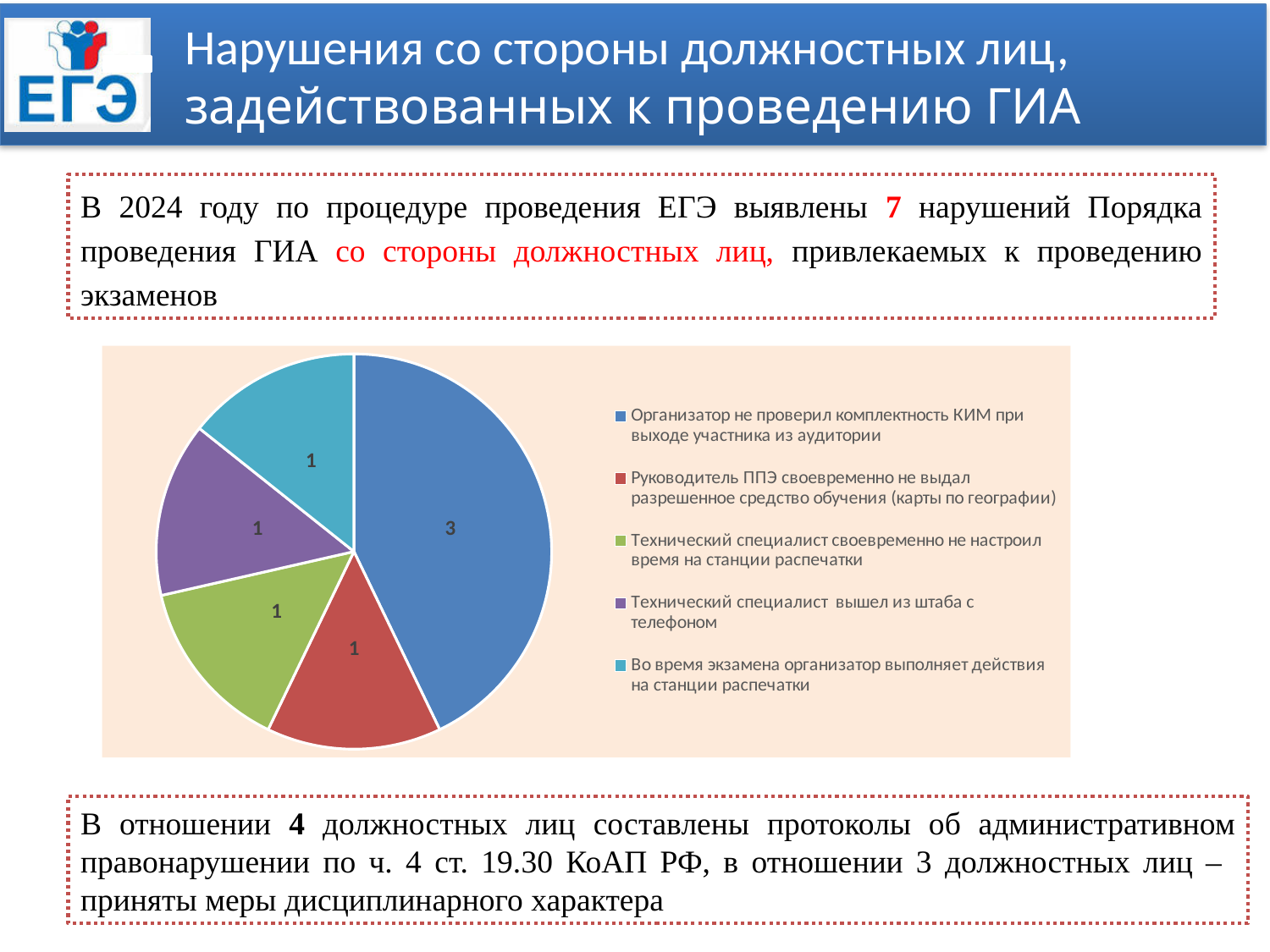
How many entries does the legend of the pie chart list? 5 How many slices does the pie chart have? 5 What colour is the slice for "Технический специалист вышел из штаба с телефоном"? purple What kind of chart is shown on the slide? pie chart Which is larger: the slice for "Организатор не проверил комплектность КИМ при выходе участника из аудитории" or the slice for "Технический специалист своевременно не настроил время на станции распечатки"? Организатор не проверил комплектность КИМ при выходе участника из аудитории What is the value of the slice for "Технический специалист вышел из штаба с телефоном"? 1 What share of the pie does the slice for "Организатор не проверил комплектность КИМ при выходе участника из аудитории" represent? 3 out of 7 What is the value of the slice for "Руководитель ППЭ своевременно не выдал разрешенное средство обучения (карты по географии)"? 1 What is the difference between the value for "Организатор не проверил комплектность КИМ при выходе участника из аудитории" and the value for "Во время экзамена организатор выполняет действия на станции распечатки"? 2 What is the total of all slice values in the pie chart? 7 What is the value of the slice for "Организатор не проверил комплектность КИМ при выходе участника из аудитории"? 3 Which category has the largest slice in the pie chart? Организатор не проверил комплектность КИМ при выходе участника из аудитории